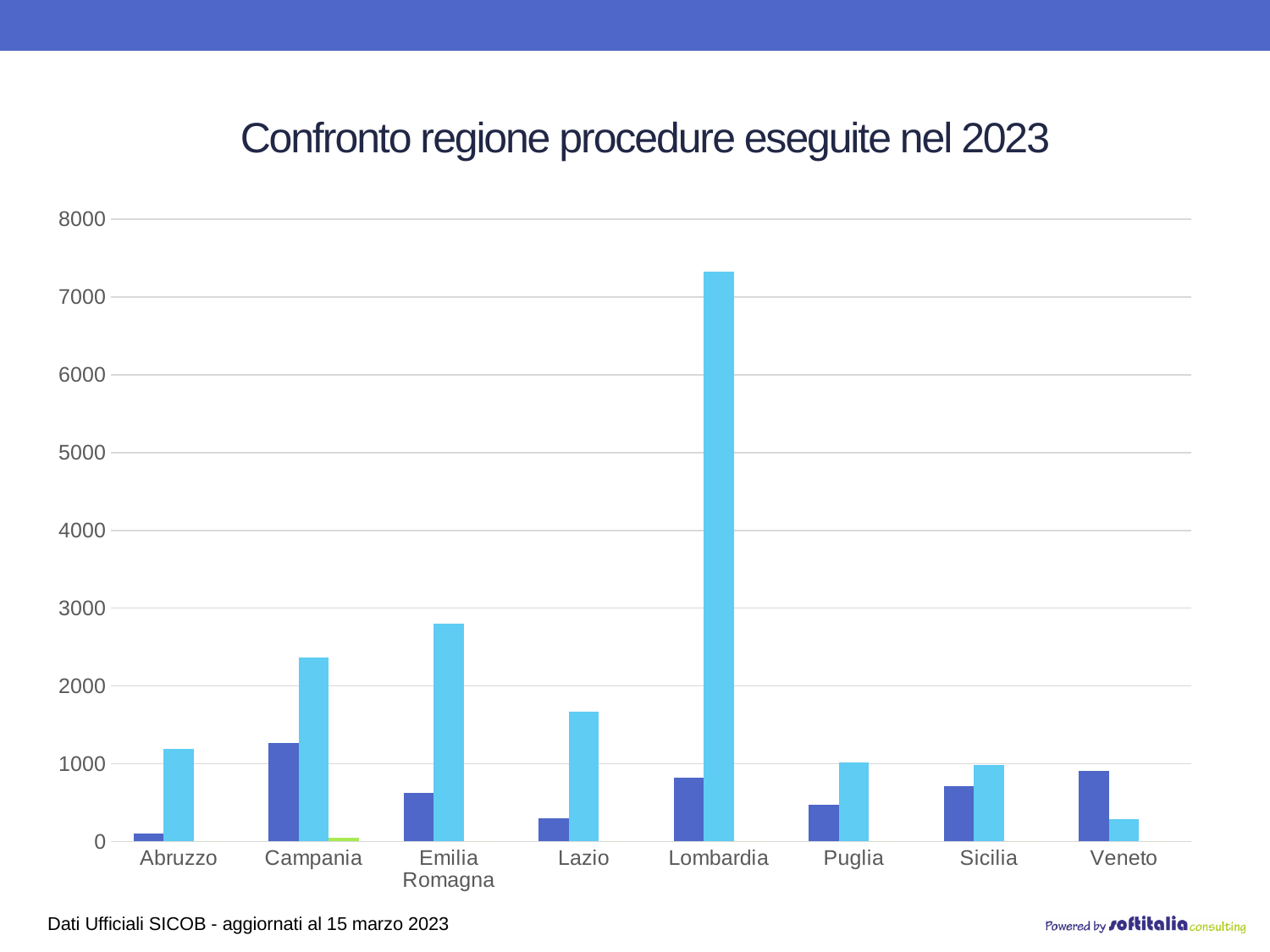
Is the dark blue bar for Campania greater or less than 1000? greater Which region has the tallest dark blue bar? Campania Is the light blue bar for Lombardia greater or less than 7000? greater Which region has the shortest light blue bar? Veneto How many regions are shown on the x axis of the chart? 8 Which region has the tallest light blue bar? Lombardia Which region is the only one with a green bar? Campania Which region has the shortest dark blue bar? Abruzzo Which is larger, the light blue bar for Campania or the light blue bar for Lazio? Campania What kind of chart is shown on the slide? bar chart What is the title of the chart? Confronto regione procedure eseguite nel 2023 Is the light blue bar for Emilia Romagna greater or less than 3000? less